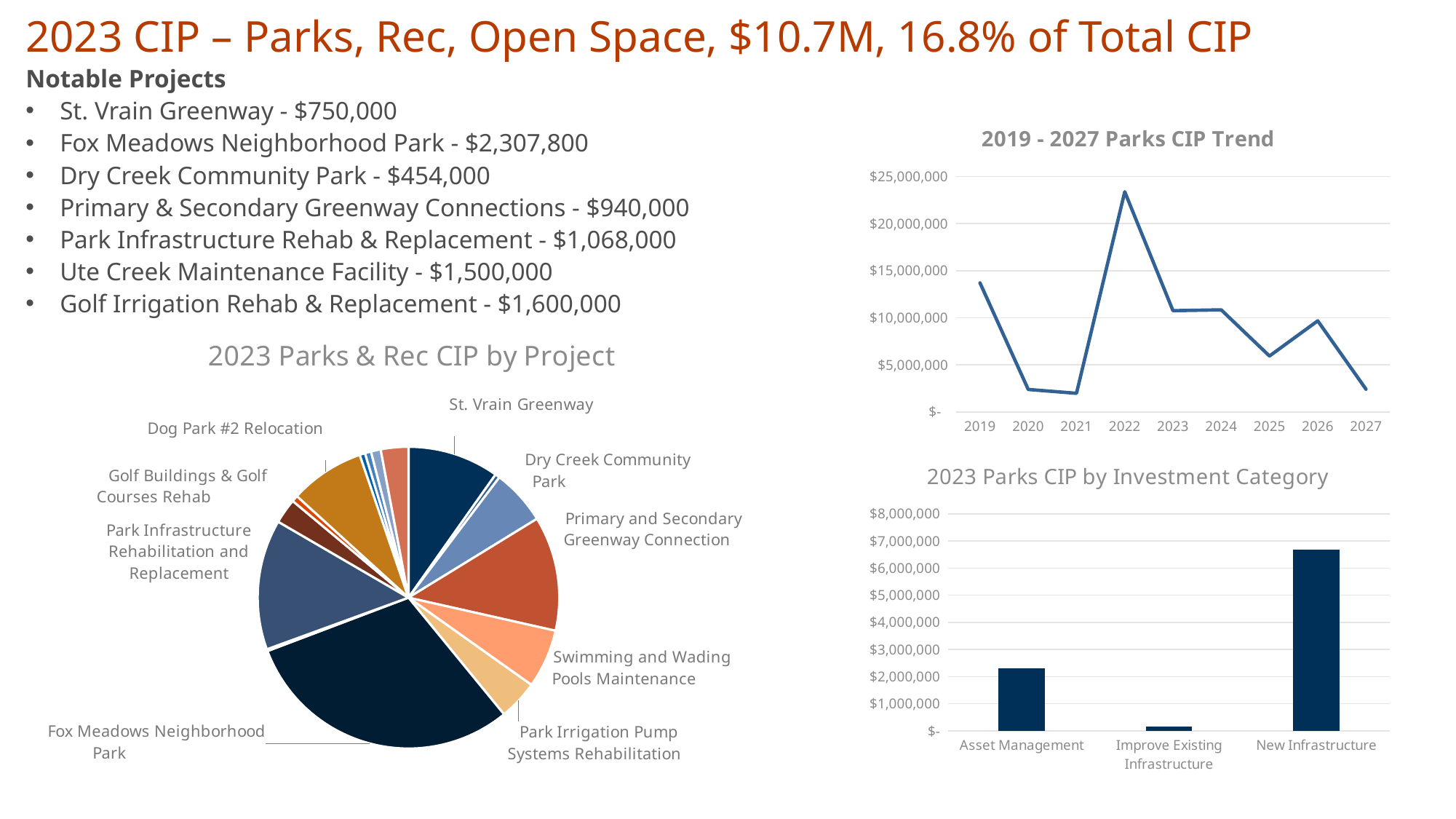
What type of chart is the '2023 Parks CIP by Investment Category' chart? Bar chart In the '2019 - 2027 Parks CIP Trend' chart, is the value for 2022 greater or less than $20,000,000? greater What type of chart is the '2023 Parks & Rec CIP by Project' chart? Pie chart In the '2023 Parks CIP by Investment Category' chart, is the value for New Infrastructure greater or less than $6,000,000? greater In the '2023 Parks & Rec CIP by Project' pie chart, which project has the largest slice? Fox Meadows Neighborhood Park In the '2019 - 2027 Parks CIP Trend' chart, which year has the higher value: 2019 or 2026? 2019 In the '2019 - 2027 Parks CIP Trend' chart, do the values rise or fall from 2022 to 2027 overall? Fall In the '2019 - 2027 Parks CIP Trend' chart, how many years are plotted on the x axis? 9 In the '2019 - 2027 Parks CIP Trend' chart, which year has the highest value? 2022 In the '2023 Parks & Rec CIP by Project' pie chart, which slice is larger: Fox Meadows Neighborhood Park or St. Vrain Greenway? Fox Meadows Neighborhood Park In the '2019 - 2027 Parks CIP Trend' chart, is the value for 2019 greater or less than $15,000,000? less In the '2023 Parks CIP by Investment Category' chart, which category has the highest value? New Infrastructure